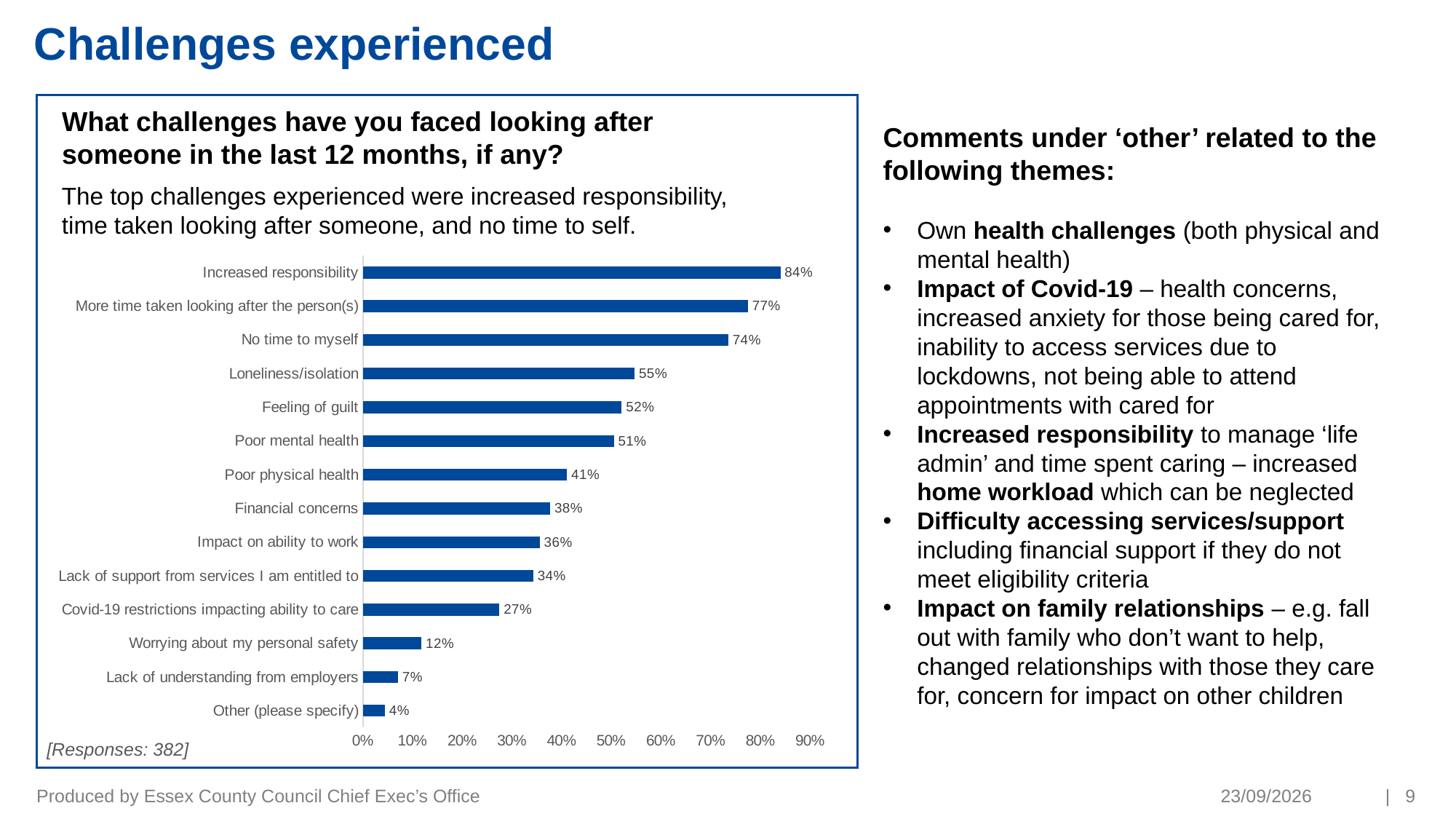
What is the value shown for 'Loneliness/isolation'? 55% Which is larger: 'Financial concerns' or 'Impact on ability to work'? Financial concerns What percentage is shown for 'Lack of understanding from employers'? 7% What is the difference between 'No time to myself' and 'Poor physical health'? 33 percentage points How many responses does the chart note say it is based on? 382 Which challenge has the highest percentage? Increased responsibility Is the value for 'Covid-19 restrictions impacting ability to care' greater or less than 30%? less What kind of chart is shown on the slide? Bar chart Which category has the lowest percentage? Other (please specify) How many categories are shown in the chart? 14 What is the difference between 'More time taken looking after the person(s)' and 'Worrying about my personal safety'? 65 percentage points What percentage of respondents reported 'Increased responsibility' as a challenge? 84%